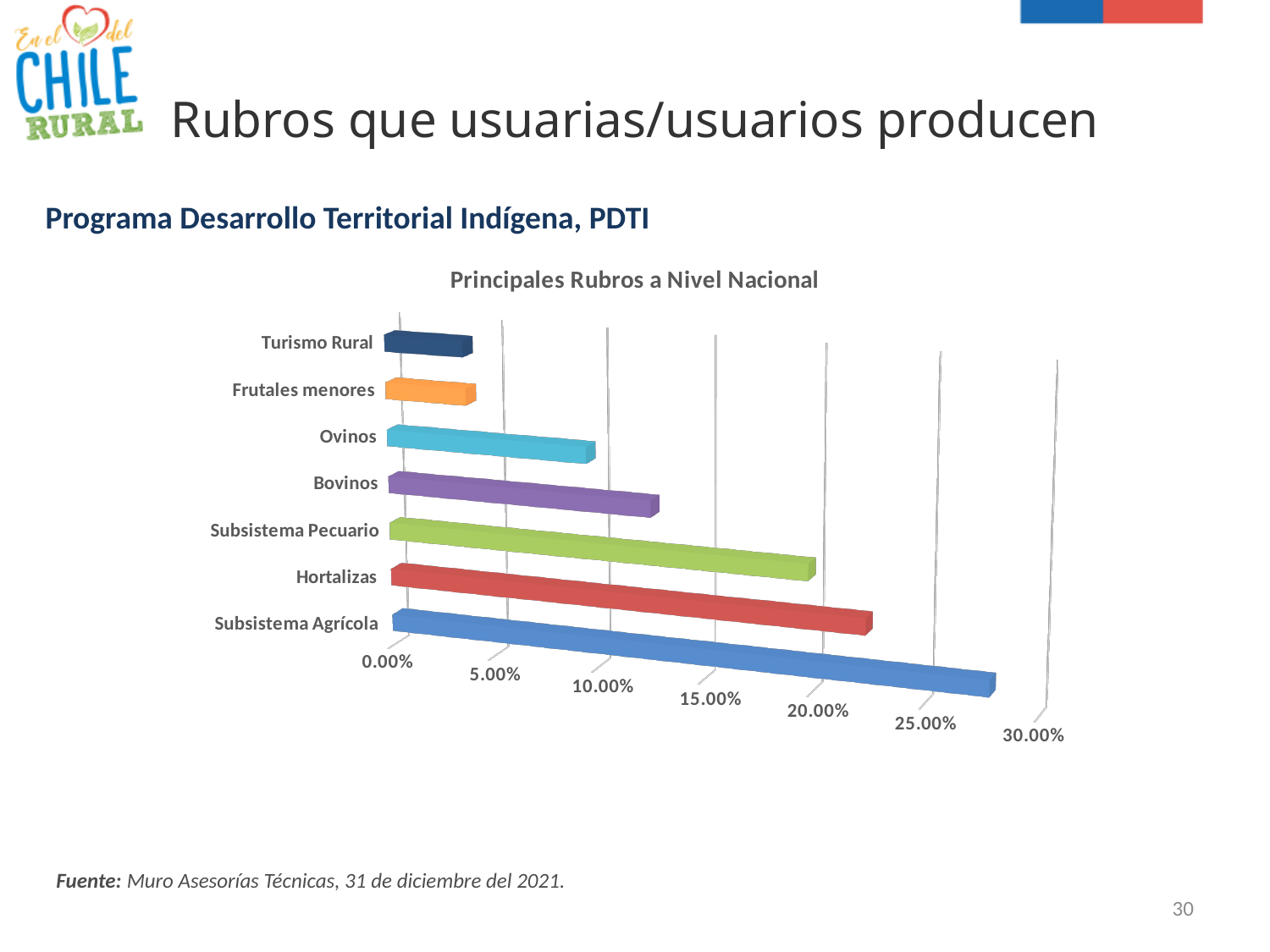
What is the title of the chart? Principales Rubros a Nivel Nacional Is the value for Frutales menores greater or less than 5.00%? less Is the value for Hortalizas greater or less than 20.00%? greater How many categories are plotted in the chart? 7 Which has a larger value, Ovinos or Turismo Rural? Ovinos Is the value for Subsistema Pecuario greater or less than 25.00%? less Which category has the highest value in the chart? Subsistema Agrícola Which has a larger value, Hortalizas or Bovinos? Hortalizas What type of chart is shown on the slide? bar chart